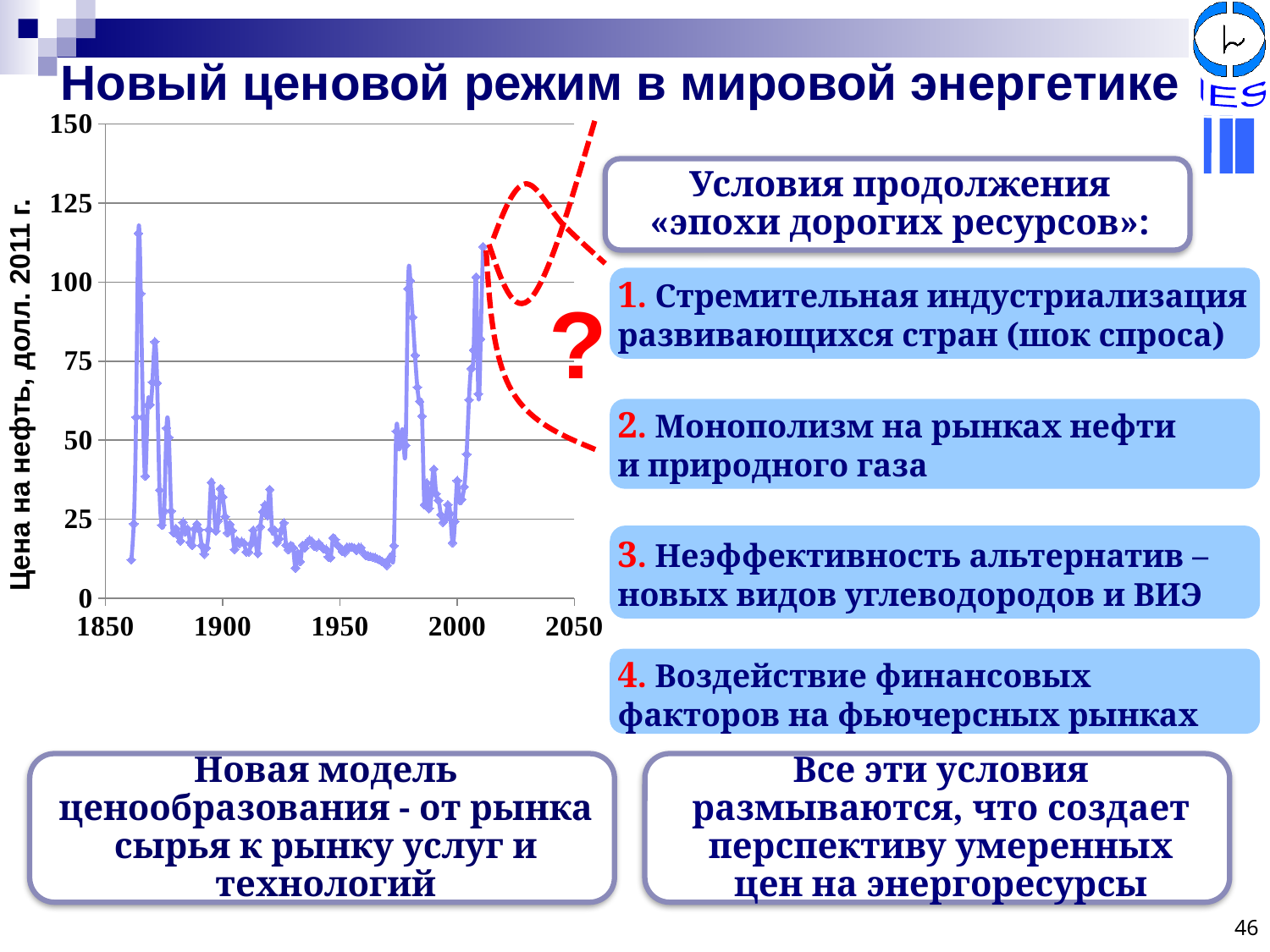
Is the oil price value around 1998 greater or less than 50? less Do the oil price values rise or fall between 1980 and 1998? fall What kind of chart is shown on the slide? line chart What is the label of the vertical axis of the chart? Цена на нефть, долл. 2011 г. Is the oil price value at the peak around 1864 greater or less than 100? greater Is the oil price value around 1950 greater or less than 25? less What is the highest value shown on the vertical axis of the chart? 150 Do the oil price values rise or fall between 1864 and 1880? fall Do the oil price values rise or fall between 2000 and 2010? rise